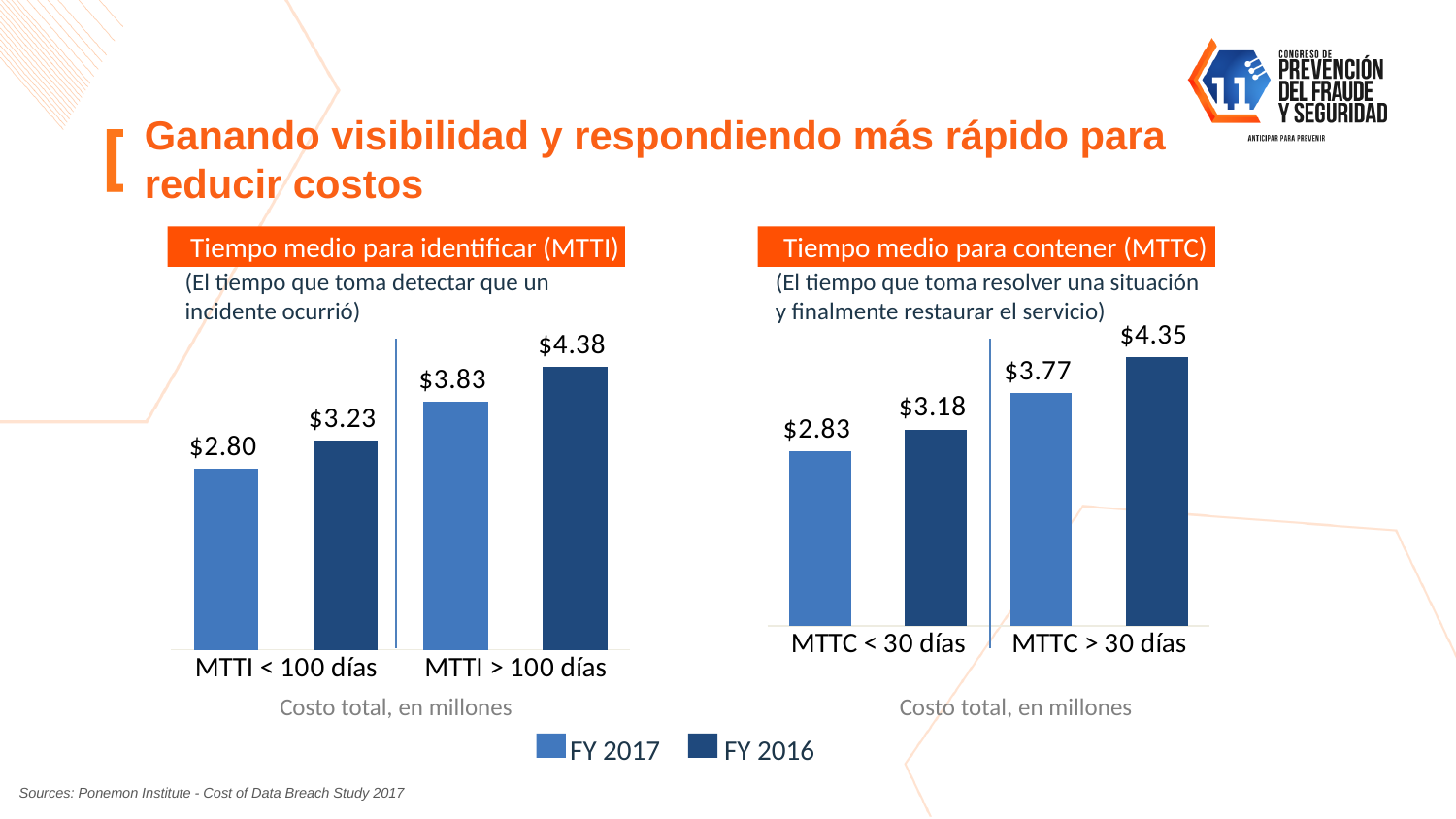
In the 'Tiempo medio para contener (MTTC)' chart, which is larger: the FY 2017 value for 'MTTC > 30 días' or the FY 2016 value for 'MTTC < 30 días'? FY 2017 value for MTTC > 30 días In the 'Tiempo medio para contener (MTTC)' chart, what is the FY 2016 value for 'MTTC < 30 días'? $3.18 Which series is shown in the darker blue colour in the legend? FY 2016 In the 'Tiempo medio para contener (MTTC)' chart, what is the FY 2017 value for 'MTTC > 30 días'? $3.77 In the 'Tiempo medio para contener (MTTC)' chart, what is the difference between the FY 2016 and FY 2017 values for 'MTTC < 30 días'? $0.35 In the 'Tiempo medio para contener (MTTC)' chart, which bar has the lowest value? FY 2017, MTTC < 30 días In the 'Tiempo medio para identificar (MTTI)' chart, what is the FY 2017 value for 'MTTI < 100 días'? $2.80 How many series does the legend list for the charts on the slide? 2 In the 'Tiempo medio para identificar (MTTI)' chart, which bar has the highest value? FY 2016, MTTI > 100 días In the 'Tiempo medio para identificar (MTTI)' chart, what is the FY 2016 value for 'MTTI > 100 días'? $4.38 In the 'Tiempo medio para identificar (MTTI)' chart, what is the difference between the FY 2016 and FY 2017 values for 'MTTI > 100 días'? $0.55 What kind of chart is the 'Tiempo medio para identificar (MTTI)' chart? Bar chart